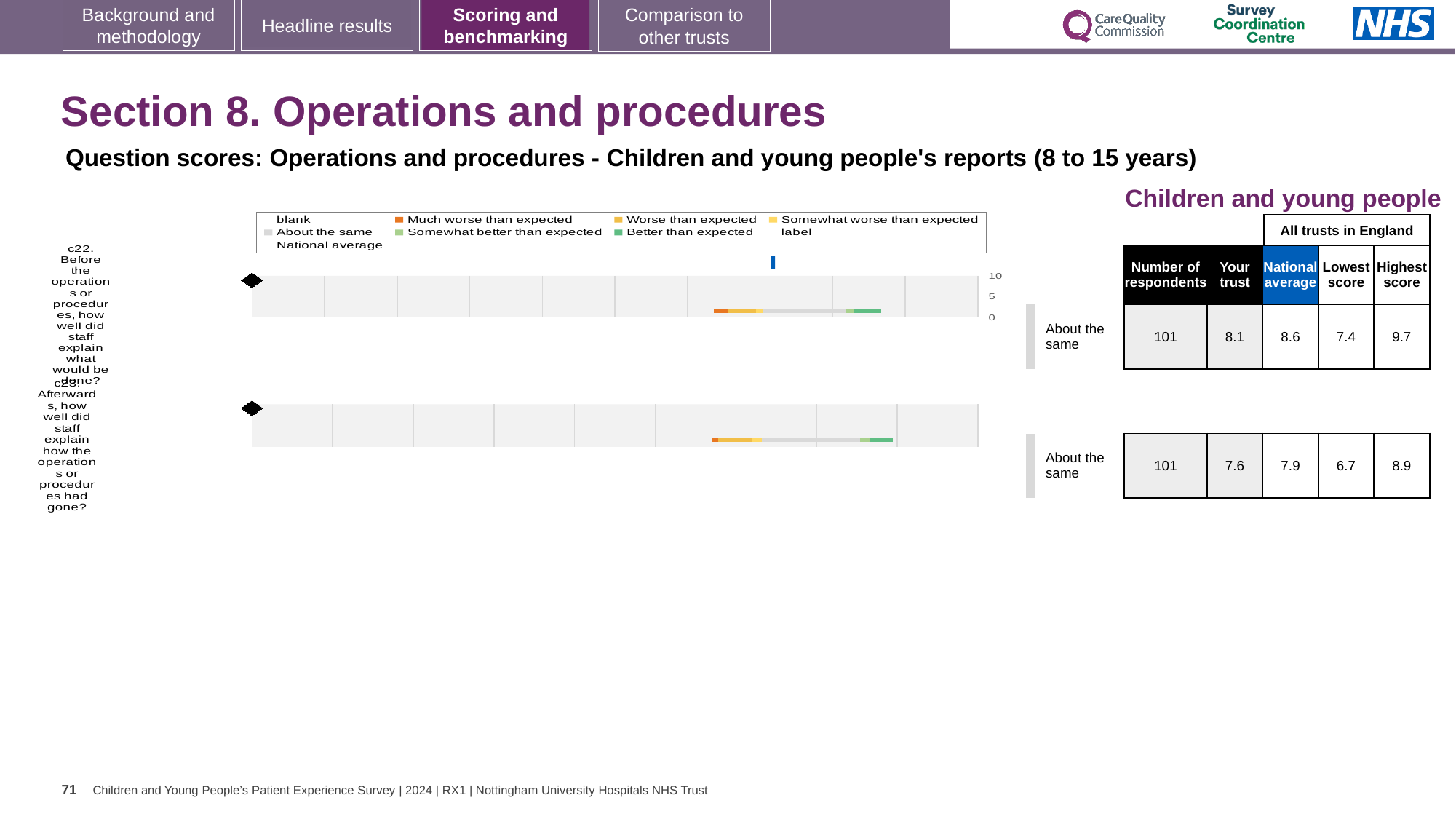
How many respondents answered question c22? 101 What is the national average score for question c22? 8.6 What is the highest score among all trusts in England for question c23? 8.9 Which question has the higher 'Your trust' score, c22 or c23? c22 How many questions (c22 and c23) are plotted on the slide? 2 What is the 'Your trust' score for question c23 (Afterwards, how well did staff explain how the operations or procedures had gone?)? 7.6 What is the 'Your trust' score for question c22 (Before the operations or procedures, how well did staff explain what would be done?)? 8.1 What type of chart is used to show the question scores for c22 and c23? bar chart What is the difference between the highest and lowest scores for question c22? 2.3 What benchmark category is shown for question c23? About the same In the legend, what colour represents 'Much worse than expected'? orange What is the difference between the national average and the 'Your trust' score for question c22? 0.5